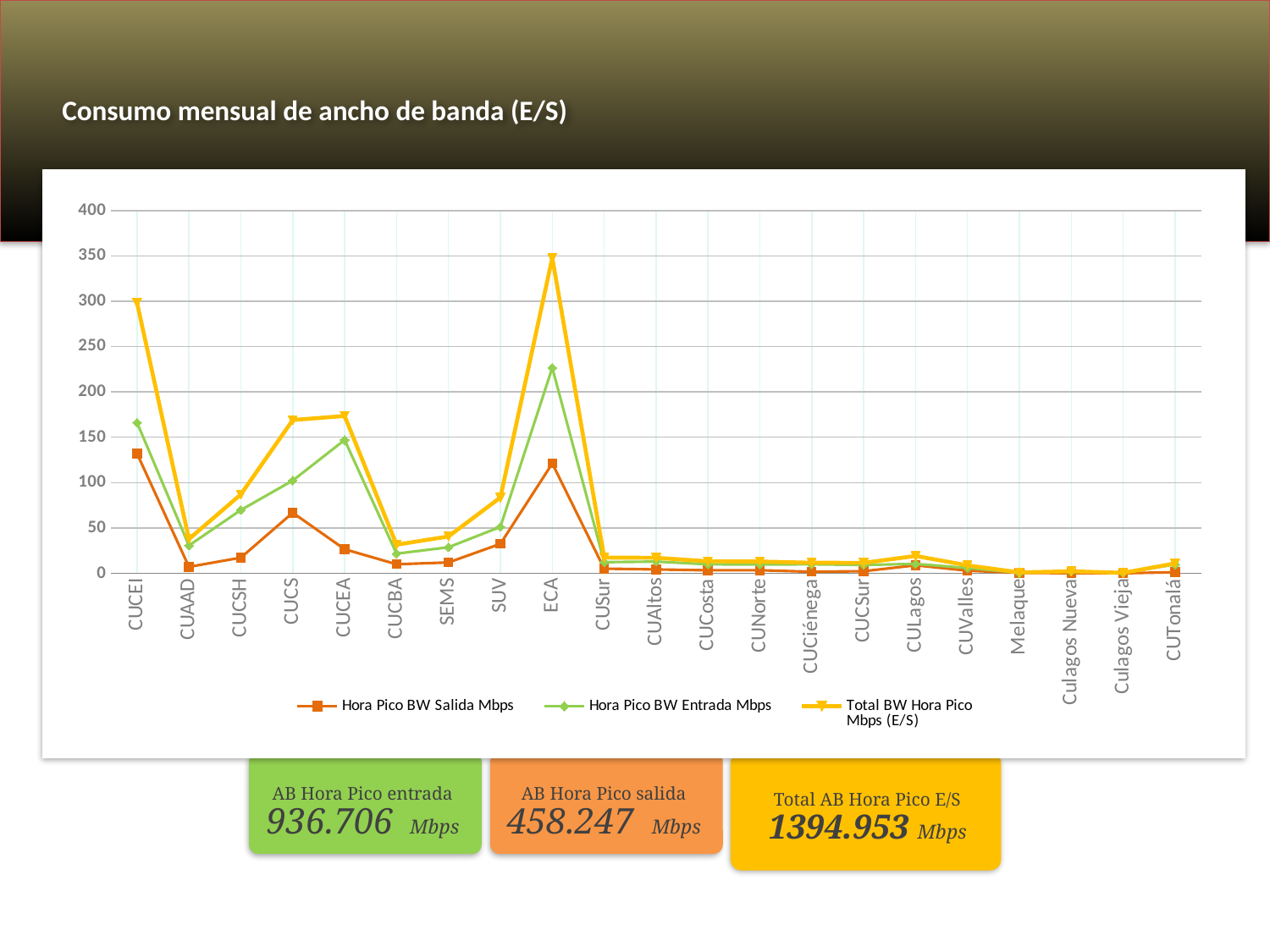
What kind of chart is shown on the slide? line chart Is the Hora Pico BW Entrada Mbps value for CUCEA greater or less than 100? greater Which category has the highest value for the Total BW Hora Pico Mbps (E/S) series? ECA How many series does the chart legend list? 3 Which has the larger Hora Pico BW Entrada Mbps value, CUCEI or CUCS? CUCEI Is the Hora Pico BW Salida Mbps value for CUCS greater or less than 50? greater Is the Total BW Hora Pico Mbps (E/S) value for CUAAD greater or less than 50? less What is the title of the slide's chart section? Consumo mensual de ancho de banda (E/S) How many categories are plotted along the x axis of the chart? 21 Do the Total BW Hora Pico Mbps (E/S) values rise or fall from CUCEI to CUAAD? fall Which category has the highest value for the Hora Pico BW Entrada Mbps series? ECA